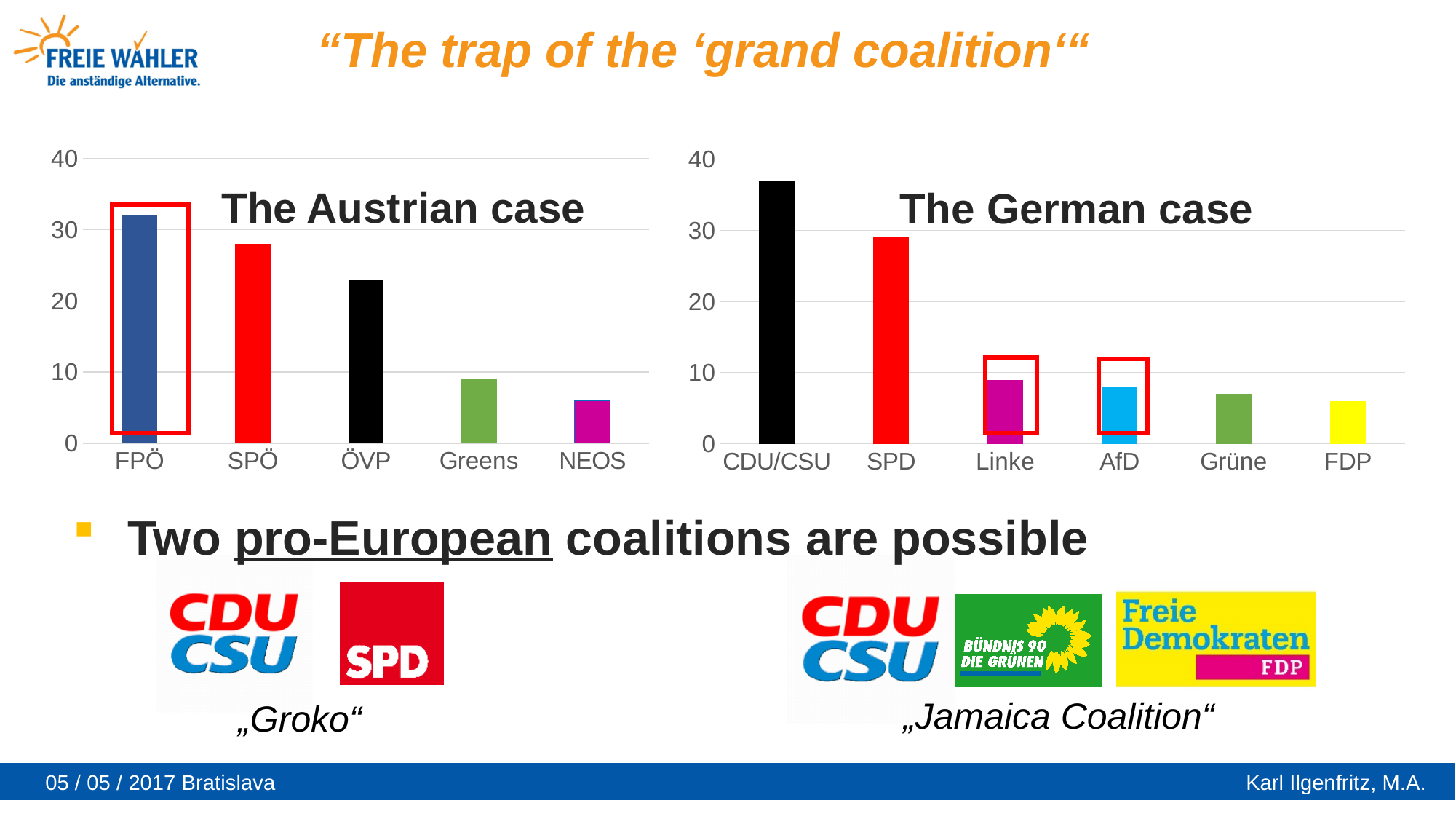
In 'The Austrian case' chart, how many parties are shown on the x axis? 5 In 'The Austrian case' chart, which party has the highest bar? FPÖ In 'The German case' chart, which is larger, the value for CDU/CSU or the value for SPD? CDU/CSU What kind of chart is 'The Austrian case'? bar chart In 'The Austrian case' chart, is the value for FPÖ greater or less than 30? greater In 'The Austrian case' chart, which is larger, the value for SPÖ or the value for ÖVP? SPÖ In 'The German case' chart, how many parties are shown on the x axis? 6 In 'The German case' chart, which party has the highest bar? CDU/CSU In 'The German case' chart, is the value for SPD greater or less than 20? greater In 'The German case' chart, is the value for AfD greater or less than 10? less In 'The Austrian case' chart, which party has the lowest bar? NEOS